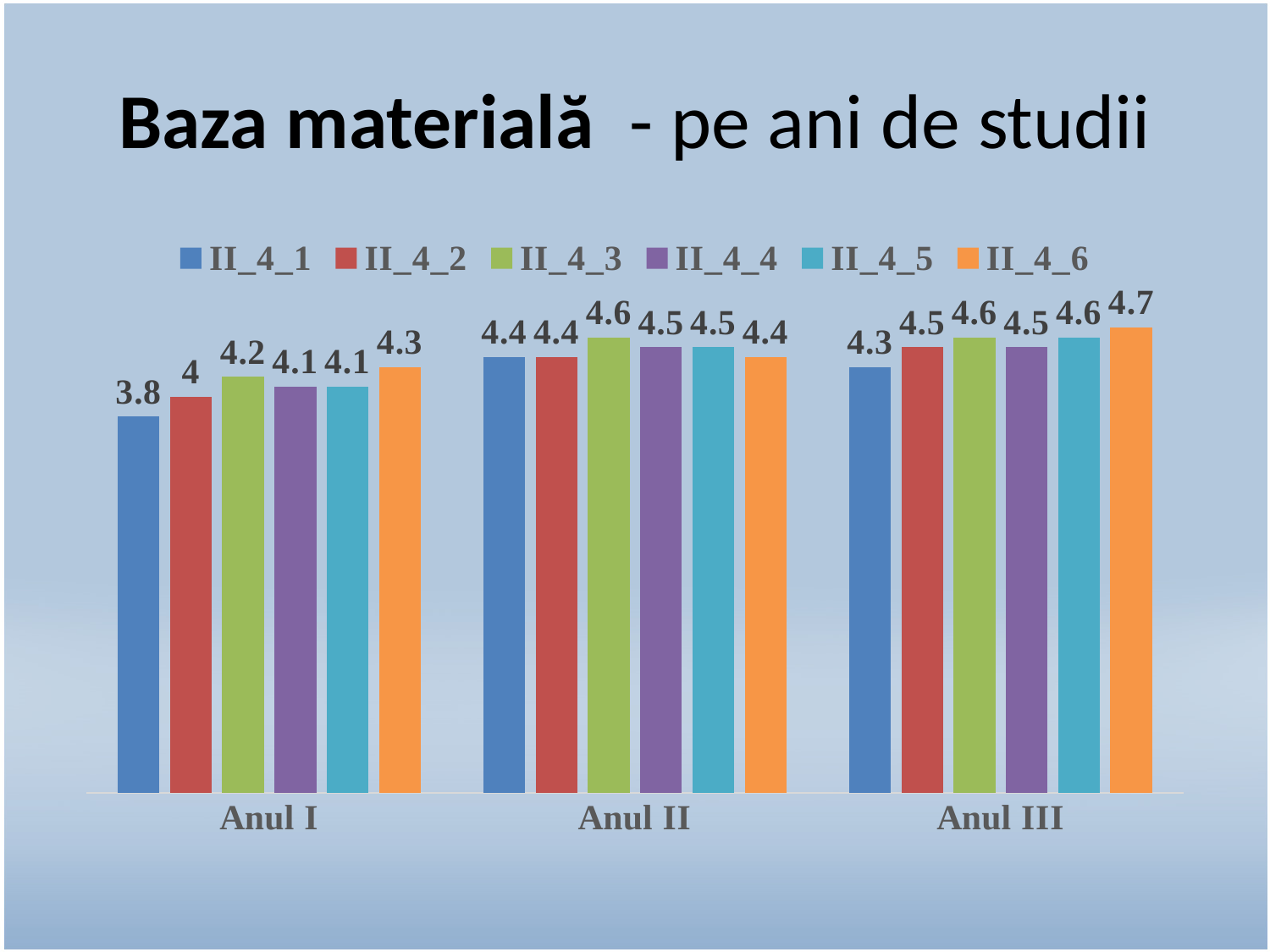
How many categories are shown on the x axis? 3 What is the value of II_4_3 for Anul II? 4.6 Which series has the highest value for Anul III? II_4_6 Does the value of II_4_3 rise or fall from Anul I to Anul II? Rise How many series does the legend list? 6 What is the value of II_4_1 for Anul I? 3.8 What is the difference between the II_4_6 value for Anul III and the II_4_6 value for Anul I? 0.4 What is the value of II_4_2 for Anul I? 4 Which series has the lowest value for Anul I? II_4_1 What is the value of II_4_6 for Anul III? 4.7 Which is larger: the II_4_1 value for Anul II or the II_4_1 value for Anul I? Anul II What kind of chart is shown on the slide? Bar chart